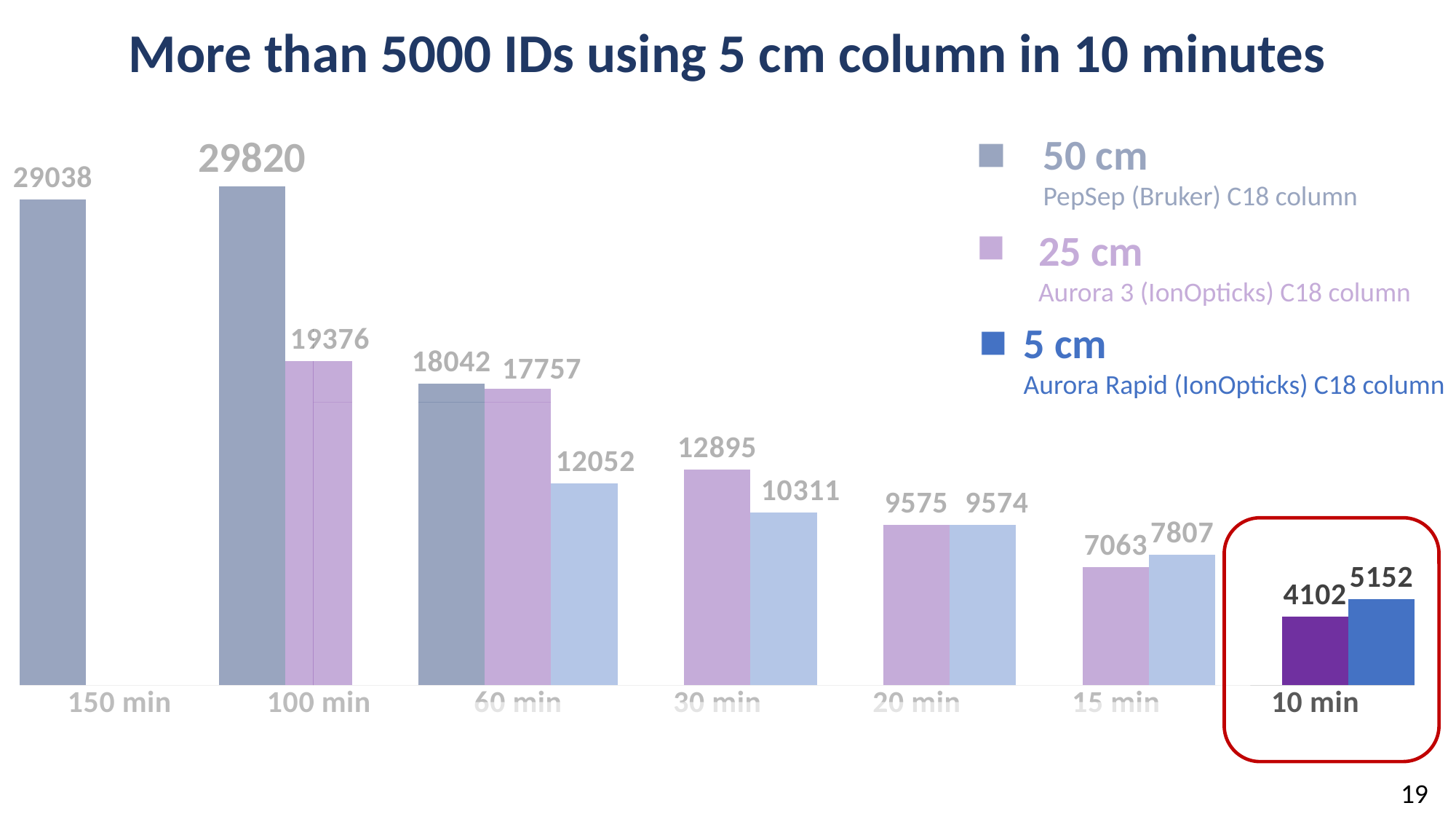
Which column does the legend describe as the Aurora Rapid (IonOpticks) C18 column? 5 cm At 15 min, which column has the larger value, 25 cm or 5 cm? 5 cm What is the value for the 50 cm column at 100 min? 29820 What is the value for the 25 cm column at 10 min? 4102 Which category has the highest value for the 50 cm column? 100 min What is the value for the 5 cm column at 10 min? 5152 What is the difference between the 5 cm and 25 cm values at 10 min? 1050 What is the value for the 5 cm column at 60 min? 12052 How many series does the legend list? 3 How many gradient-time categories are shown on the x axis? 7 What kind of chart is shown on the slide? bar chart Which category has the lowest value for the 5 cm column? 10 min